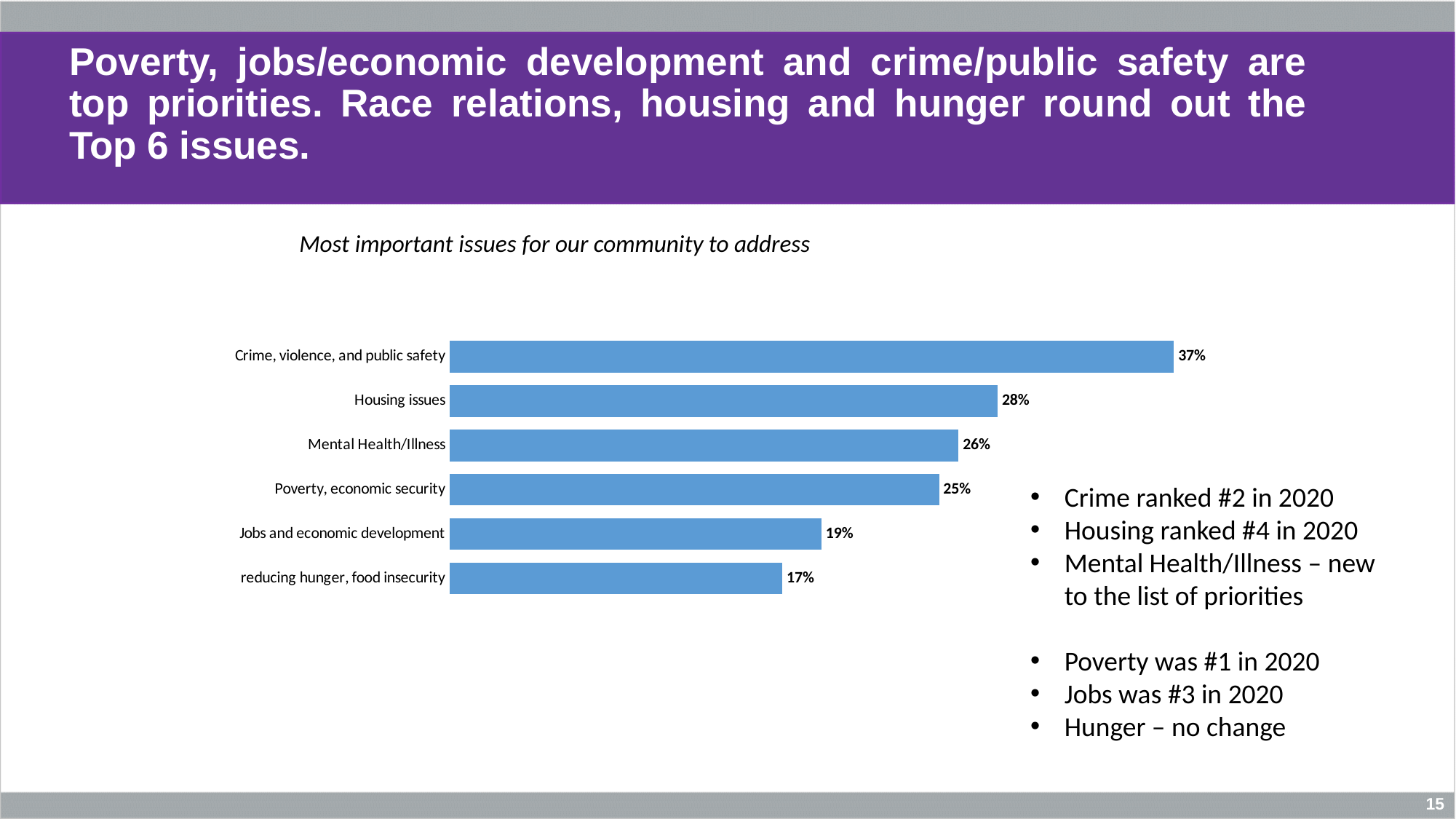
What is the difference between the values for Poverty, economic security and reducing hunger, food insecurity? 8% Which category has the lowest value? reducing hunger, food insecurity Which category has the highest value? Crime, violence, and public safety What is the value for Housing issues? 28% What is the value for Jobs and economic development? 19% What is the value for Crime, violence, and public safety? 37% What is the difference between the values for Crime, violence, and public safety and Housing issues? 9% How many categories are shown in the chart? 6 What is the title of the chart? Most important issues for our community to address What is the value for Mental Health/Illness? 26% What kind of chart is shown on the slide? Bar chart Which is larger, the value for Housing issues or the value for Jobs and economic development? Housing issues